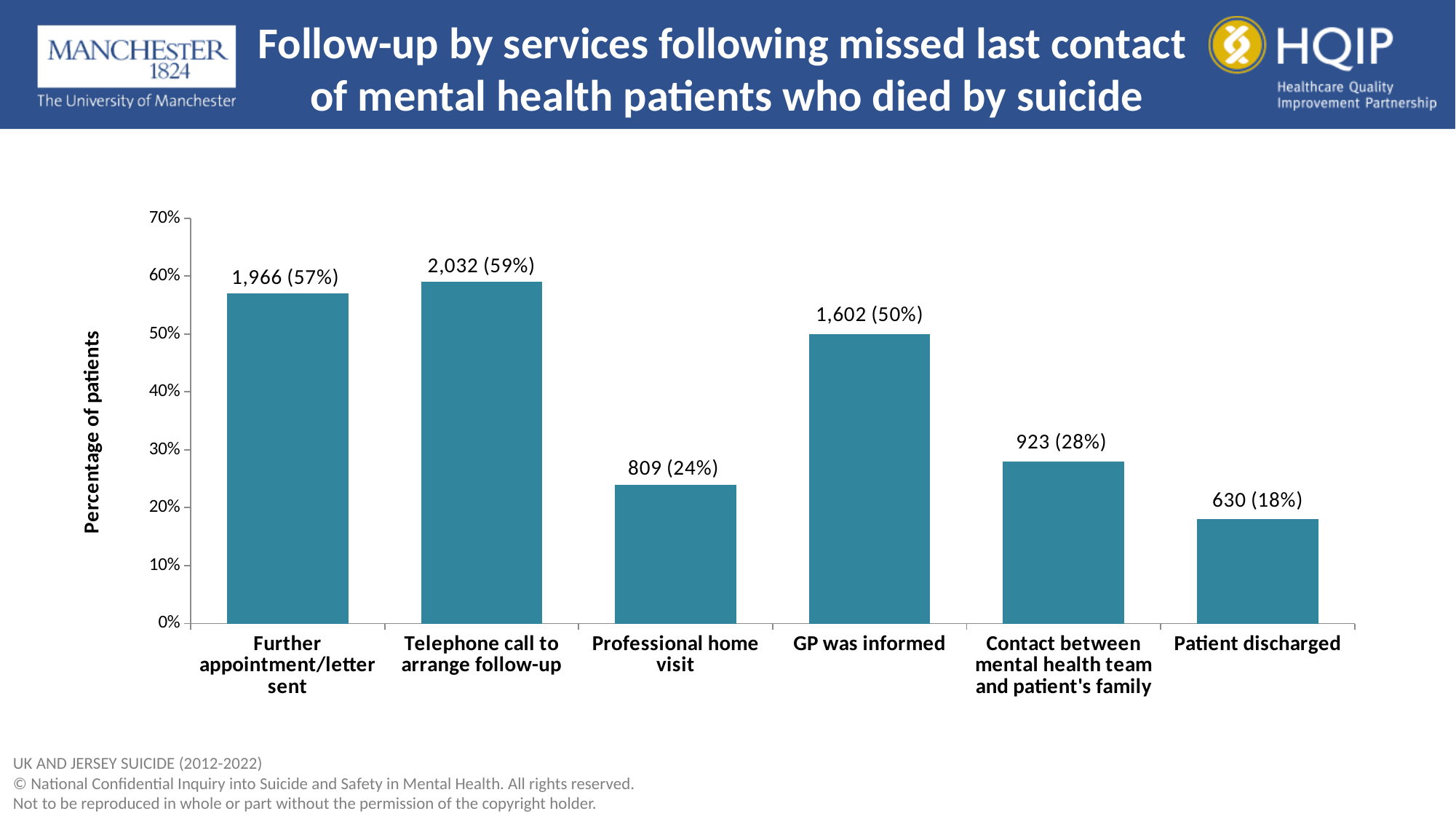
Which category has the lowest value? Patient discharged What is the label of the y axis? Percentage of patients What is the difference in percentage points between 'Contact between mental health team and patient's family' and 'Patient discharged'? 10 Which category has the highest value? Telephone call to arrange follow-up Which is larger, the value for 'GP was informed' or the value for 'Professional home visit'? GP was informed How many patients are shown for 'Professional home visit'? 809 What is the data label for 'Patient discharged'? 630 (18%) What is the difference in number of patients between 'Telephone call to arrange follow-up' and 'Further appointment/letter sent'? 66 What kind of chart is shown on the slide? Bar chart What percentage of patients had a 'Telephone call to arrange follow-up'? 59% How many categories are shown on the x axis? 6 What is the data label for 'GP was informed'? 1,602 (50%)